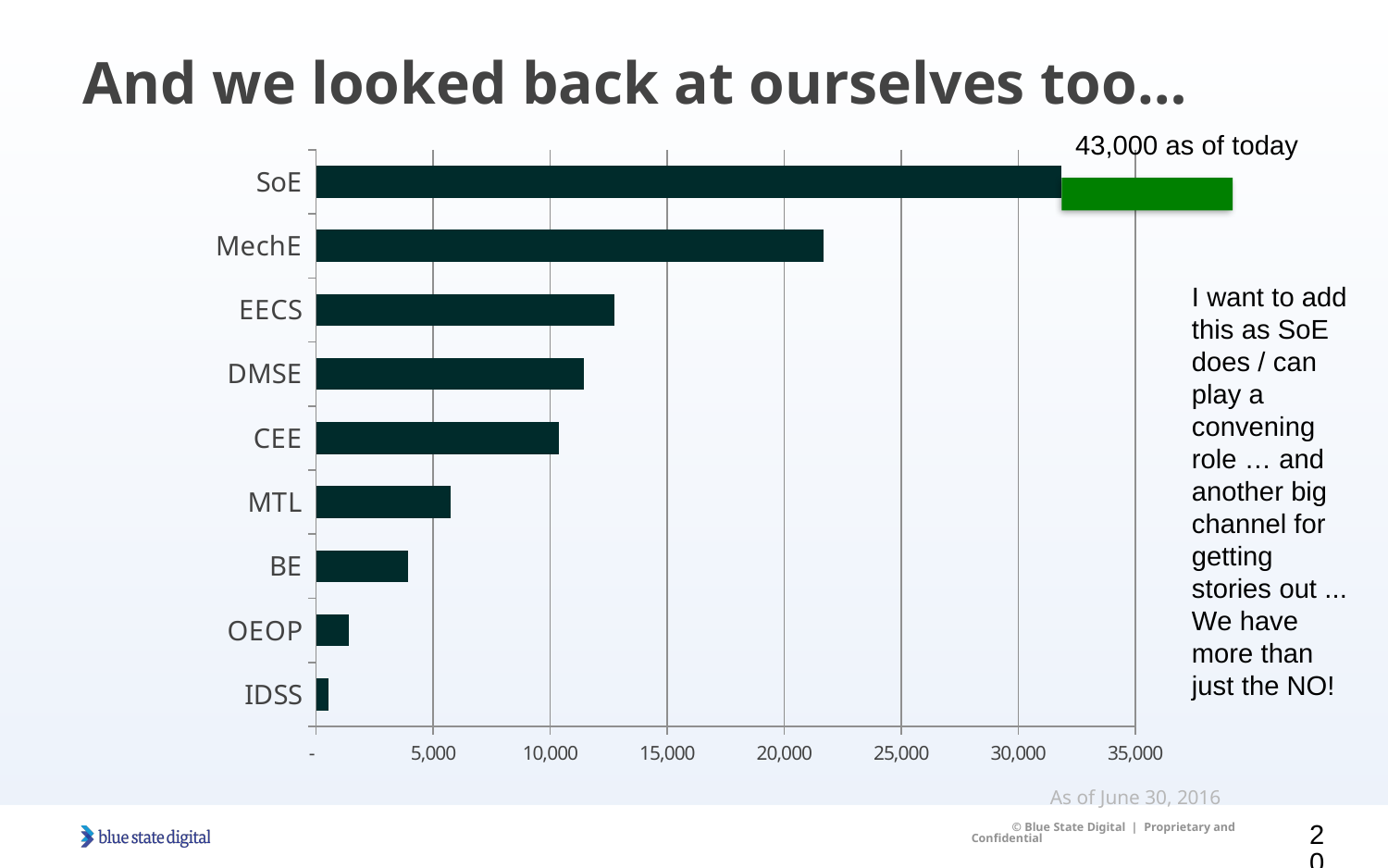
Which category has the highest value on the chart? SoE Is the value for CEE greater or less than 10,000? greater Which has the larger value, MTL or BE? MTL Which has the larger value, MechE or EECS? MechE Is the value for BE greater or less than 5,000? less Is the value for SoE (dark bar) greater or less than 30,000? greater Do the bar values increase or decrease going from the top category to the bottom category? Decrease Which category has the lowest value on the chart? IDSS What value does the annotation above the green bar give for SoE as of today? 43,000 as of today What kind of chart is shown on the slide? Bar chart How many categories are plotted on the chart? 9